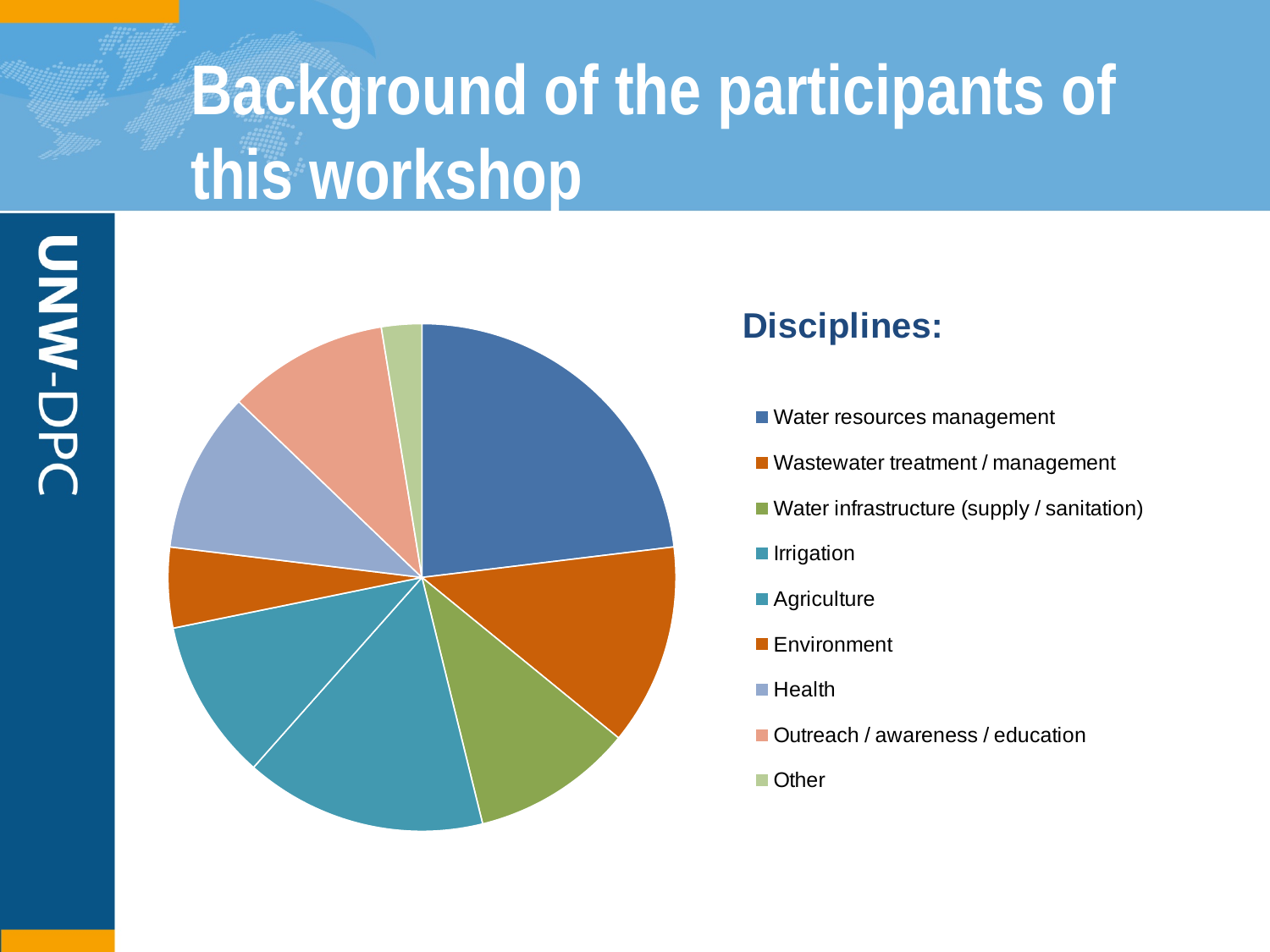
What is the heading shown next to the pie chart's legend? Disciplines: Which slice is larger, Irrigation or Environment? Irrigation Which slice is larger, Irrigation or Health? Irrigation Which slice is larger, Wastewater treatment / management or Other? Wastewater treatment / management What kind of chart is shown on the slide? pie chart How many categories (slices) does the pie chart have? 9 What is the last entry listed in the pie chart's legend? Other Which discipline has the largest slice of the pie chart? Water resources management Which discipline has the smallest slice of the pie chart? Other